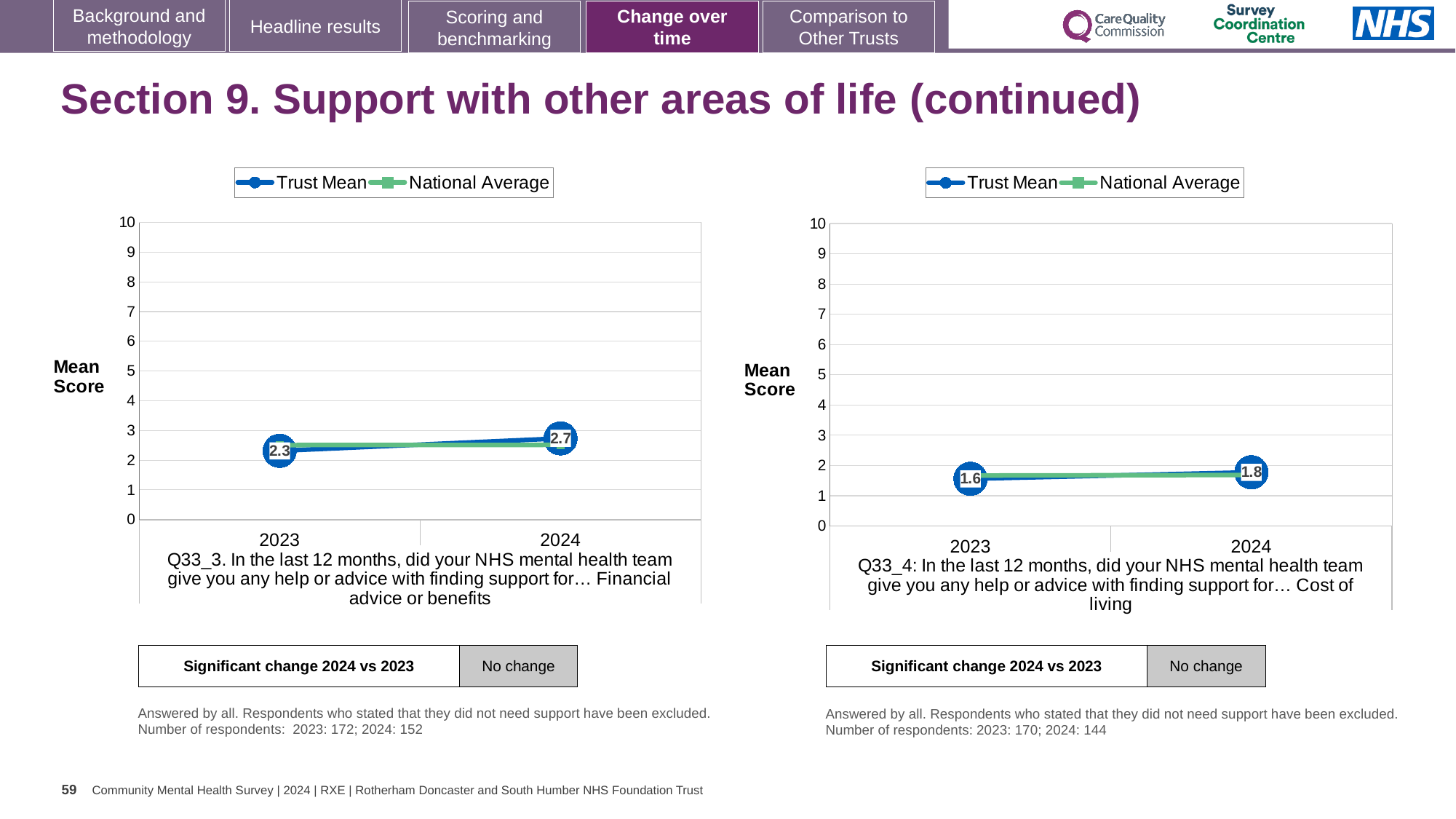
What kind of chart is the left chart (Q33_3)? line chart On the left chart (Q33_3), does the Trust Mean rise or fall from 2023 to 2024? rise How many years are plotted on the x axis of the left chart (Q33_3)? 2 On the right chart (Q33_4, Cost of living), what is the Trust Mean for 2023? 1.6 How many series does the legend of the right chart (Q33_4) list? 2 On the right chart (Q33_4), is the National Average for 2024 greater or less than 5? less On the left chart (Q33_3, Financial advice or benefits), what is the Trust Mean for 2023? 2.3 On the left chart (Q33_3, Financial advice or benefits), what is the Trust Mean for 2024? 2.7 On the right chart (Q33_4), what is the difference between the Trust Mean for 2024 and 2023? 0.2 On the right chart (Q33_4), is the Trust Mean for 2024 higher or lower than for 2023? higher On the left chart (Q33_3), by how much did the Trust Mean change from 2023 to 2024? 0.4 On the right chart (Q33_4, Cost of living), what is the Trust Mean for 2024? 1.8